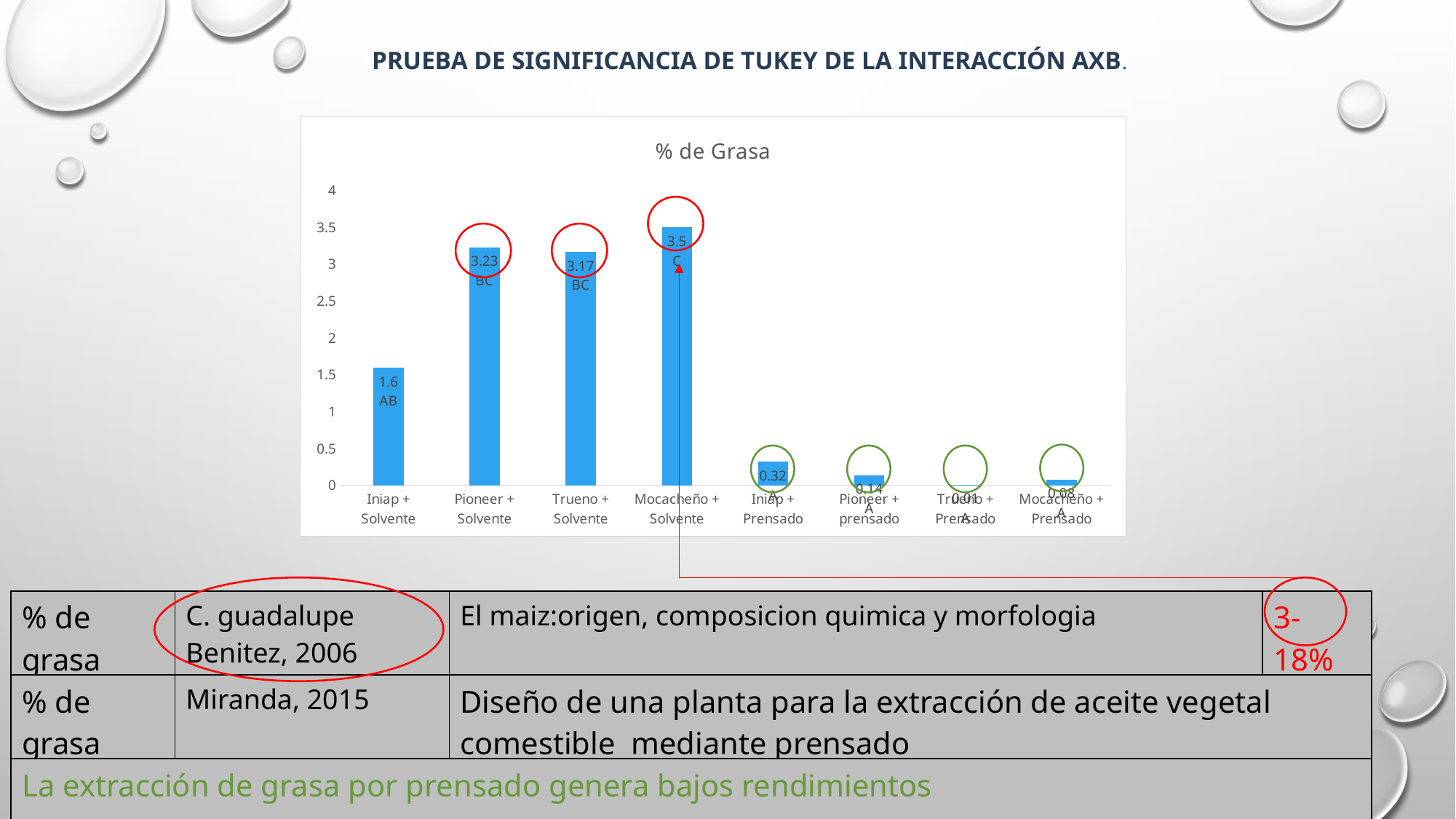
Which category has the highest value in the % de Grasa chart? Mocacheño + Solvente What is the value for Mocacheño + Solvente in the % de Grasa chart? 3.5 What is the value for Iniap + Prensado in the % de Grasa chart? 0.32 What kind of chart is shown on the slide? bar chart What is the value for Iniap + Solvente in the % de Grasa chart? 1.6 What is the difference between the values for Mocacheño + Solvente and Iniap + Solvente? 1.9 How many categories are shown in the % de Grasa chart? 8 Is the value for Iniap + Solvente greater or less than 2? less What is the value for Pioneer + Solvente in the % de Grasa chart? 3.23 Which is larger, the value for Iniap + Solvente or the value for Iniap + Prensado? Iniap + Solvente What is the difference between the values for Pioneer + Solvente and Trueno + Solvente? 0.06 What is the value for Trueno + Solvente in the % de Grasa chart? 3.17